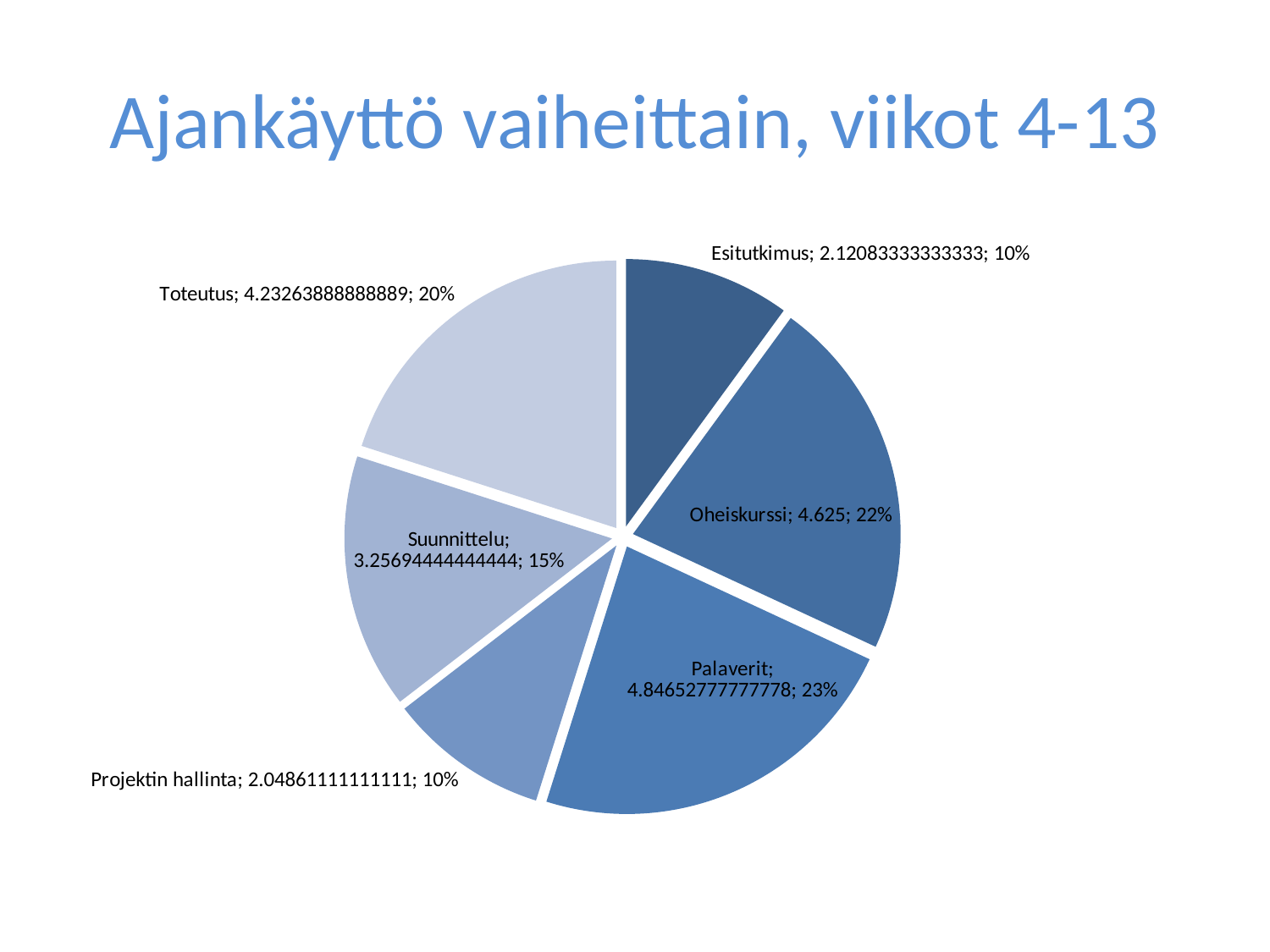
What is the value shown for Projektin hallinta? 2.04861111111111 What kind of chart is shown on the slide? pie chart What is the value shown for Toteutus? 4.23263888888889 Which category has the smallest value in the pie chart? Projektin hallinta By how many percentage points does the share of Palaverit exceed the share of Suunnittelu? 8 percentage points What is the value shown for Oheiskurssi? 4.625 What share of the pie does Suunnittelu represent? 15% What share of the pie does Esitutkimus represent? 10% Which is larger, the value for Oheiskurssi or the value for Toteutus? Oheiskurssi Which category has the largest slice of the pie? Palaverit How many slices does the pie chart have? 6 What is the title of the chart? Ajankäyttö vaiheittain, viikot 4-13